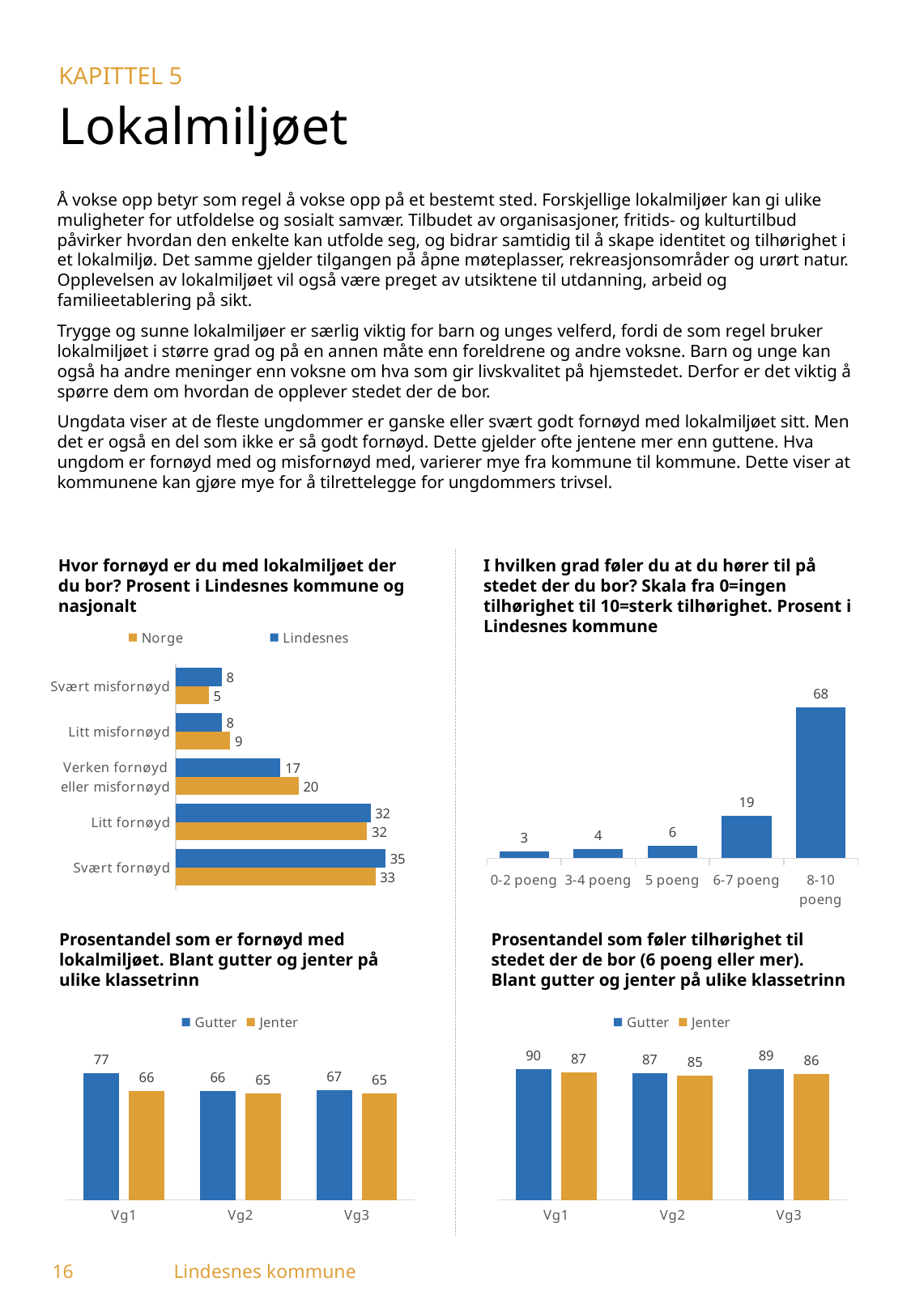
In the top-right chart (I hvilken grad føler du at du hører til på stedet der du bor?), what is the value for '6-7 poeng'? 19 In the top-left chart (Hvor fornøyd er du med lokalmiljøet der du bor?), what is the value for Lindesnes in the 'Svært fornøyd' category? 35 In the top-left chart (Hvor fornøyd er du med lokalmiljøet der du bor?), what is the value for Norge in the 'Verken fornøyd eller misfornøyd' category? 20 In the bottom-left chart (Prosentandel som er fornøyd med lokalmiljøet), what is the value for Gutter at Vg1? 77 In the top-left chart (Hvor fornøyd er du med lokalmiljøet der du bor?), what is the difference between Norge and Lindesnes for 'Svært misfornøyd'? 3 In the bottom-right chart (Prosentandel som føler tilhørighet til stedet der de bor), what is the value for Jenter at Vg3? 86 What kind of chart is the top-right chart (I hvilken grad føler du at du hører til på stedet der du bor?)? Bar chart In the bottom-left chart (Prosentandel som er fornøyd med lokalmiljøet), what is the difference between Gutter and Jenter at Vg1? 11 How many categories are shown in the top-right chart (I hvilken grad føler du at du hører til på stedet der du bor?)? 5 In the top-right chart (I hvilken grad føler du at du hører til på stedet der du bor?), which category has the highest value? 8-10 poeng In the bottom-right chart (Prosentandel som føler tilhørighet til stedet der de bor), which is larger at Vg2: Gutter or Jenter? Gutter How many series does the legend of the top-left chart (Hvor fornøyd er du med lokalmiljøet der du bor?) list? 2